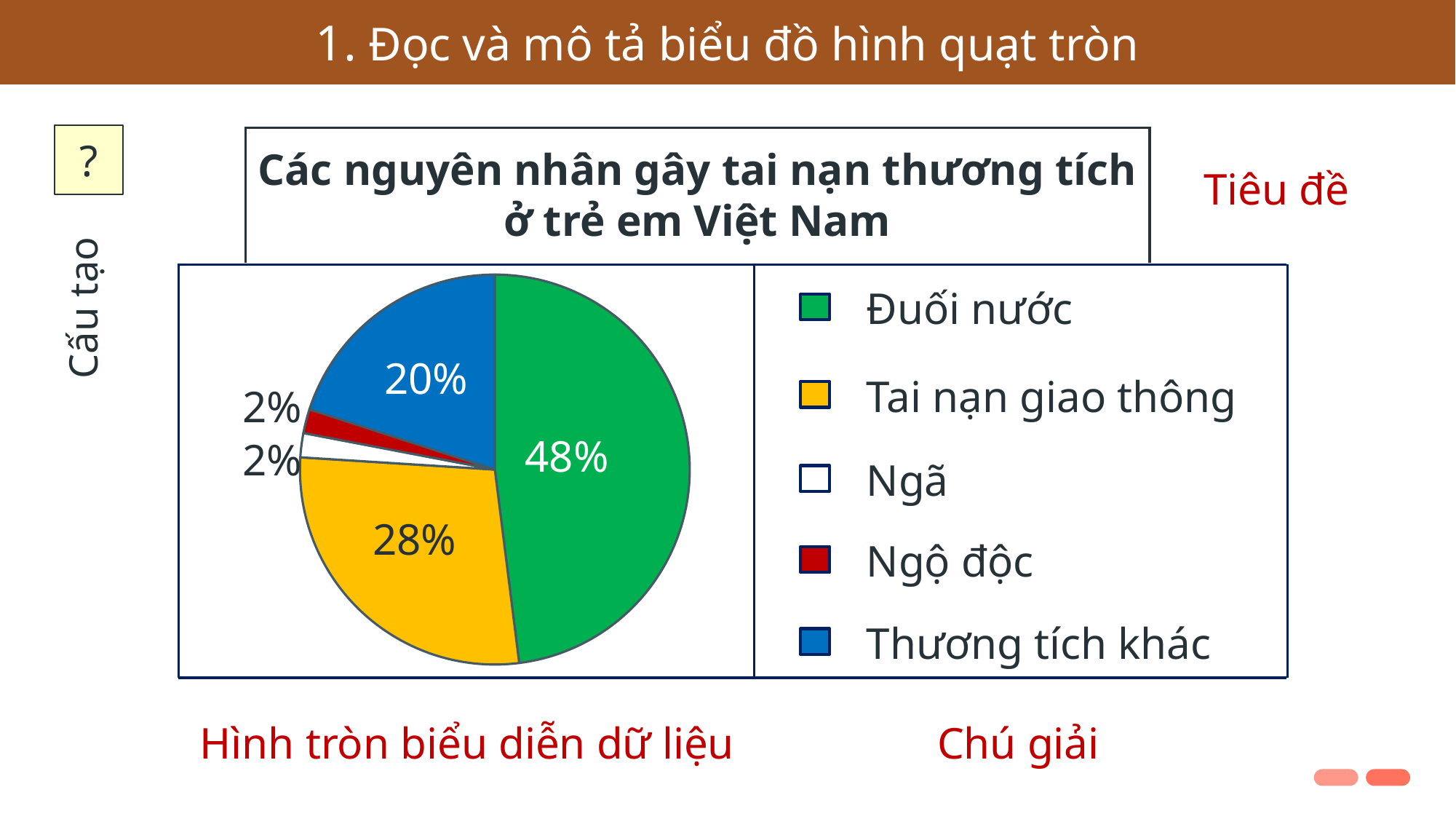
What percentage of the pie is Thương tích khác? 20% Which is larger, the share of Tai nạn giao thông or the share of Thương tích khác? Tai nạn giao thông What percentage of the pie is Ngộ độc? 2% What kind of chart is shown on the slide? pie chart What is the title of the chart? Các nguyên nhân gây tai nạn thương tích ở trẻ em Việt Nam What colour is the slice for Thương tích khác? blue What percentage of the pie is Tai nạn giao thông? 28% What is the difference between the shares of Đuối nước and Tai nạn giao thông? 20% Which category has the largest share of the pie? Đuối nước How many categories does the legend list? 5 What is the combined share of Ngã and Ngộ độc? 4% What percentage of the pie is Đuối nước? 48%